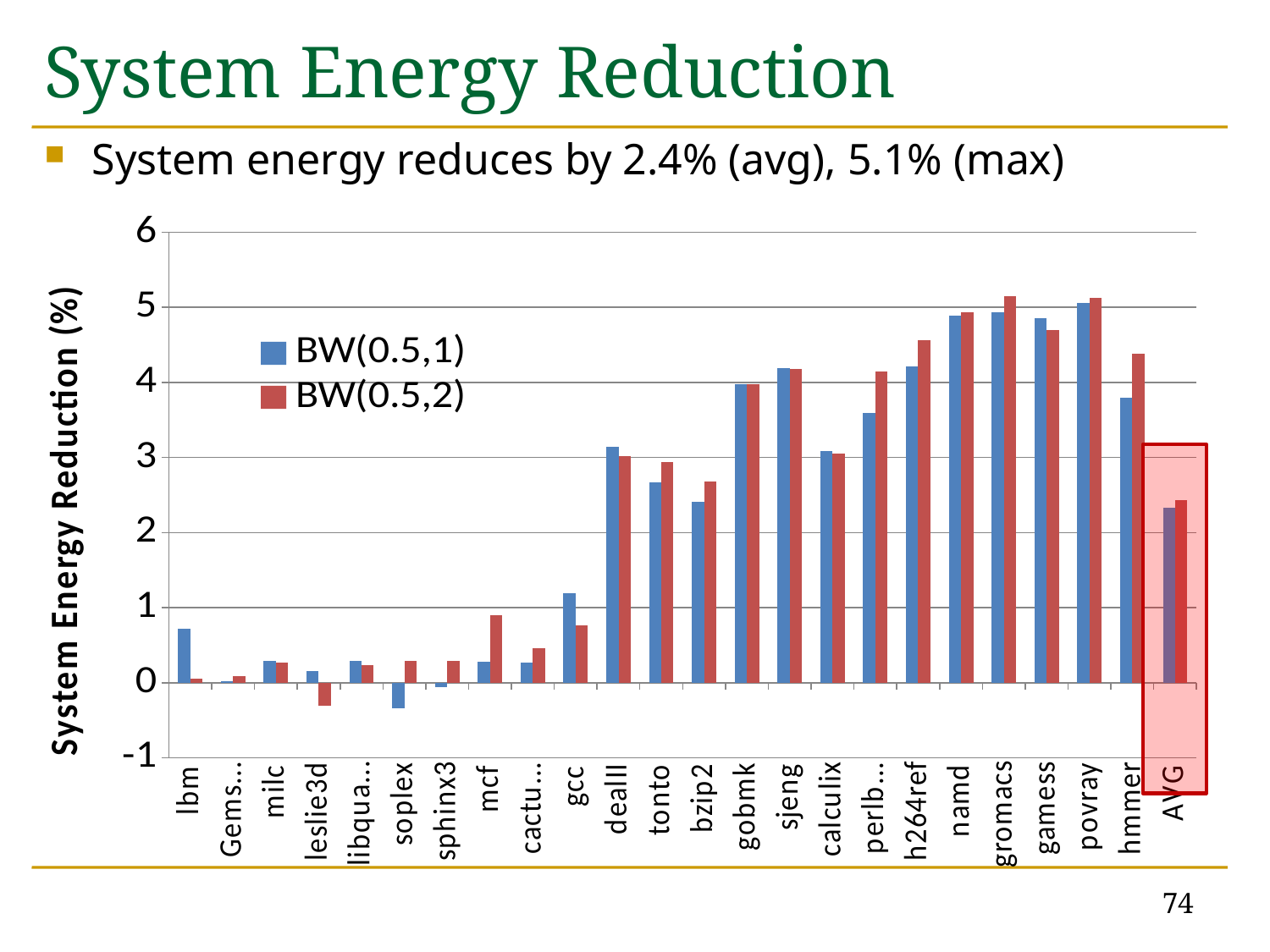
Do the values generally rise or fall moving from lbm on the left toward hmmer on the right? rise Which category has the lowest BW(0.5,2) value? leslie3d Which category has the lowest BW(0.5,1) value? soplex For hmmer, which series has the larger value, BW(0.5,1) or BW(0.5,2)? BW(0.5,2) How many series does the legend list? 2 What kind of chart is shown on the slide? bar chart Is the BW(0.5,1) value for sjeng greater or less than 4? greater For gcc, which series has the larger value, BW(0.5,1) or BW(0.5,2)? BW(0.5,1) What is the label of the y axis? System Energy Reduction (%) Is the BW(0.5,1) value for bzip2 greater or less than 2? greater How many categories are shown along the x axis? 24